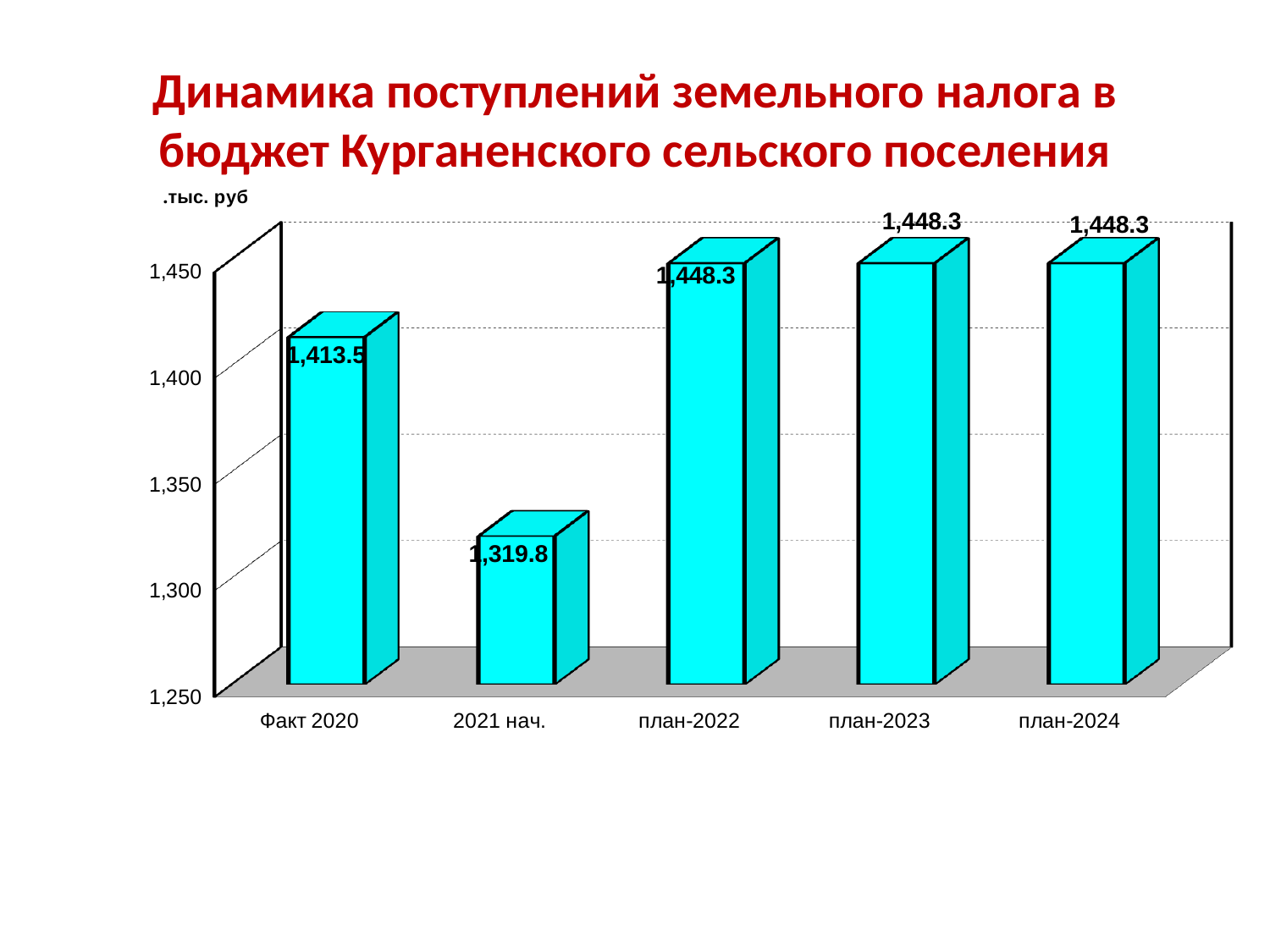
What kind of chart is shown on the slide? bar chart Is the value for 2021 нач. greater or less than 1,350? less What is the value for план-2024? 1,448.3 What is the value for план-2022? 1,448.3 What unit is indicated above the vertical axis? тыс. руб How many categories are shown on the x axis? 5 Which category has the lowest value? 2021 нач. What is the difference between the values for план-2022 and Факт 2020? 34.8 What is the value for 2021 нач.? 1,319.8 Which is larger, the value for Факт 2020 or the value for 2021 нач.? Факт 2020 What is the difference between the values for Факт 2020 and 2021 нач.? 93.7 What is the value for Факт 2020? 1,413.5